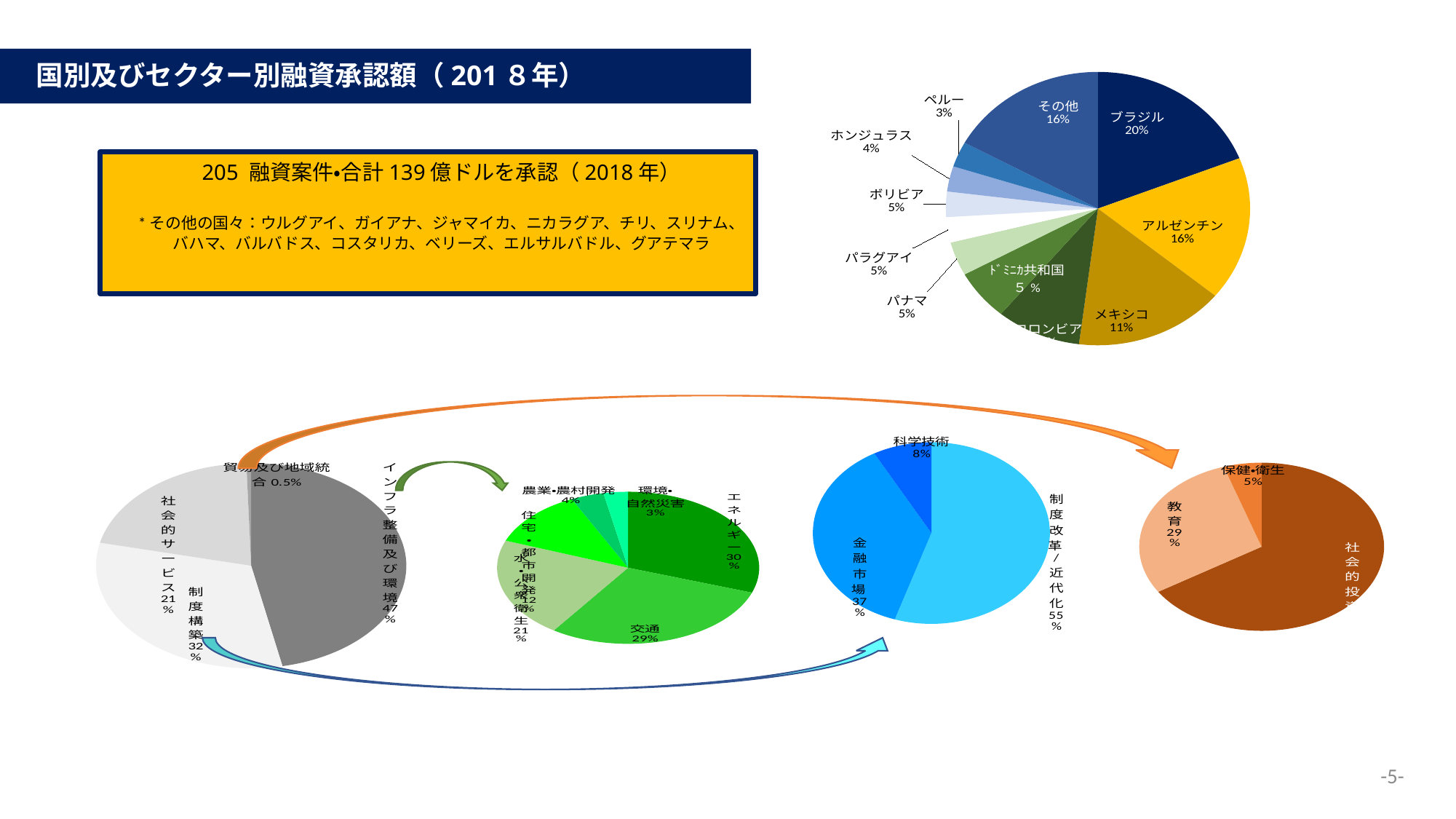
In the grey pie chart at the bottom left, how many slices are there? 4 In the grey pie chart at the bottom left, what share does インフラ整備及び環境 have? 47% In the top-right pie chart by country, what share does アルゼンチン have? 16% In the top-right pie chart by country, which is larger, the share of ホンジュラス or the share of ボリビア? ボリビア In the orange pie chart at the bottom right, what share does 教育 have? 29% In the blue pie chart at the bottom, what share does 制度改革/近代化 have? 55% In the top-right pie chart by country, what is the difference between the shares of ブラジル and メキシコ? 9% In the grey pie chart at the bottom left, what share does 貿易及び地域統合 have? 0.5% In the top-right pie chart by country, which labelled country has the smallest share? ペルー In the top-right pie chart by country, which country has the largest share? ブラジル In the green pie chart at the bottom, what share does エネルギー have? 30% In the top-right pie chart of loan approvals by country, what share does ブラジル have? 20%